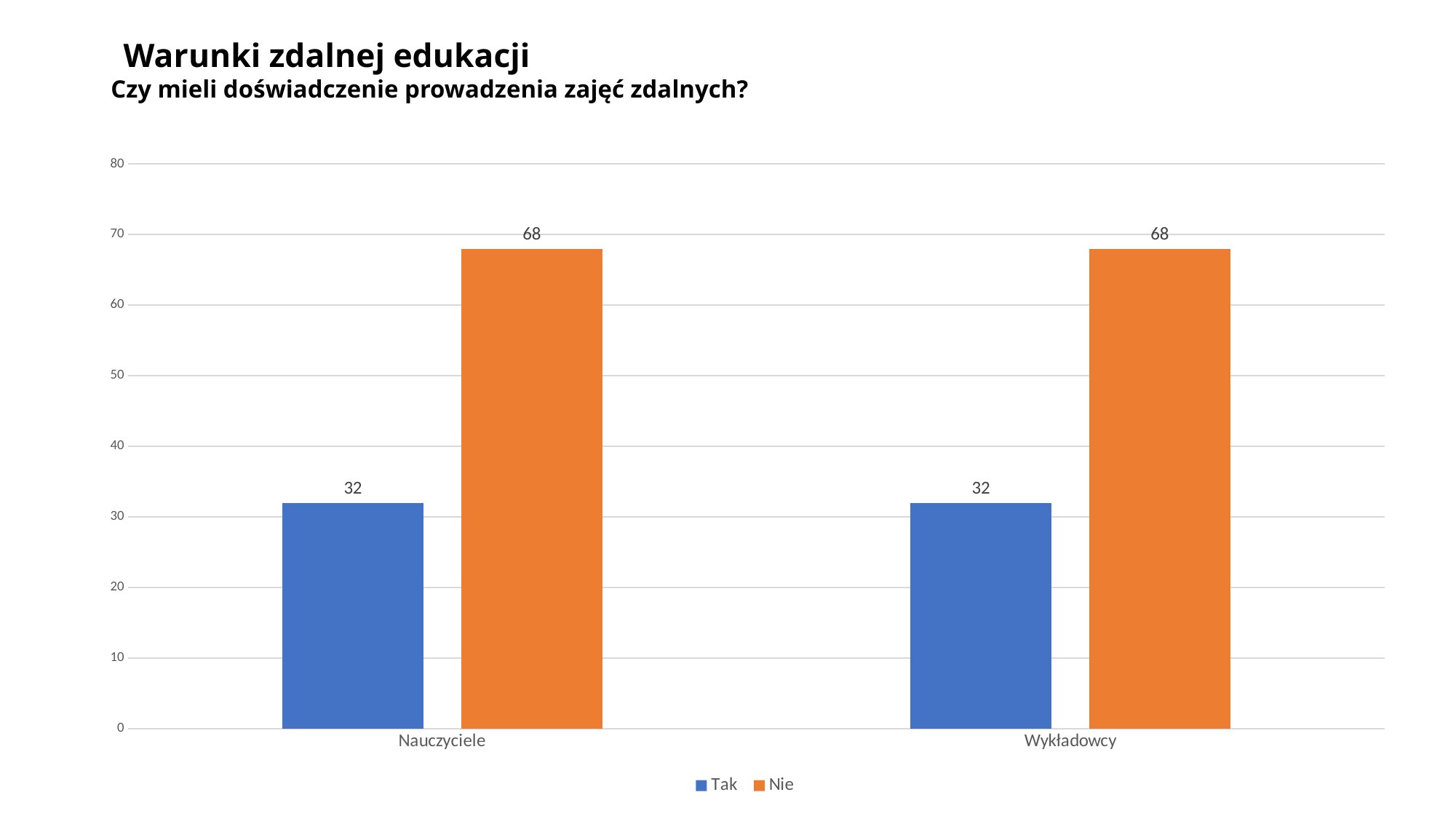
How many series does the legend list? 2 What question is the chart answering, according to the subtitle? Czy mieli doświadczenie prowadzenia zajęć zdalnych? What is the value for "Tak" for Wykładowcy? 32 What is the difference between the Nie and Tak values for Wykładowcy? 36 Which series has the higher value for Nauczyciele, Tak or Nie? Nie Which colour represents the "Nie" series? Orange What is the total of the Tak and Nie values for Nauczyciele? 100 What is the value for "Tak" for Nauczyciele? 32 How many categories are shown on the x axis? 2 What is the value for "Nie" for Nauczyciele? 68 What is the value for "Nie" for Wykładowcy? 68 What kind of chart is shown on the slide? Bar chart